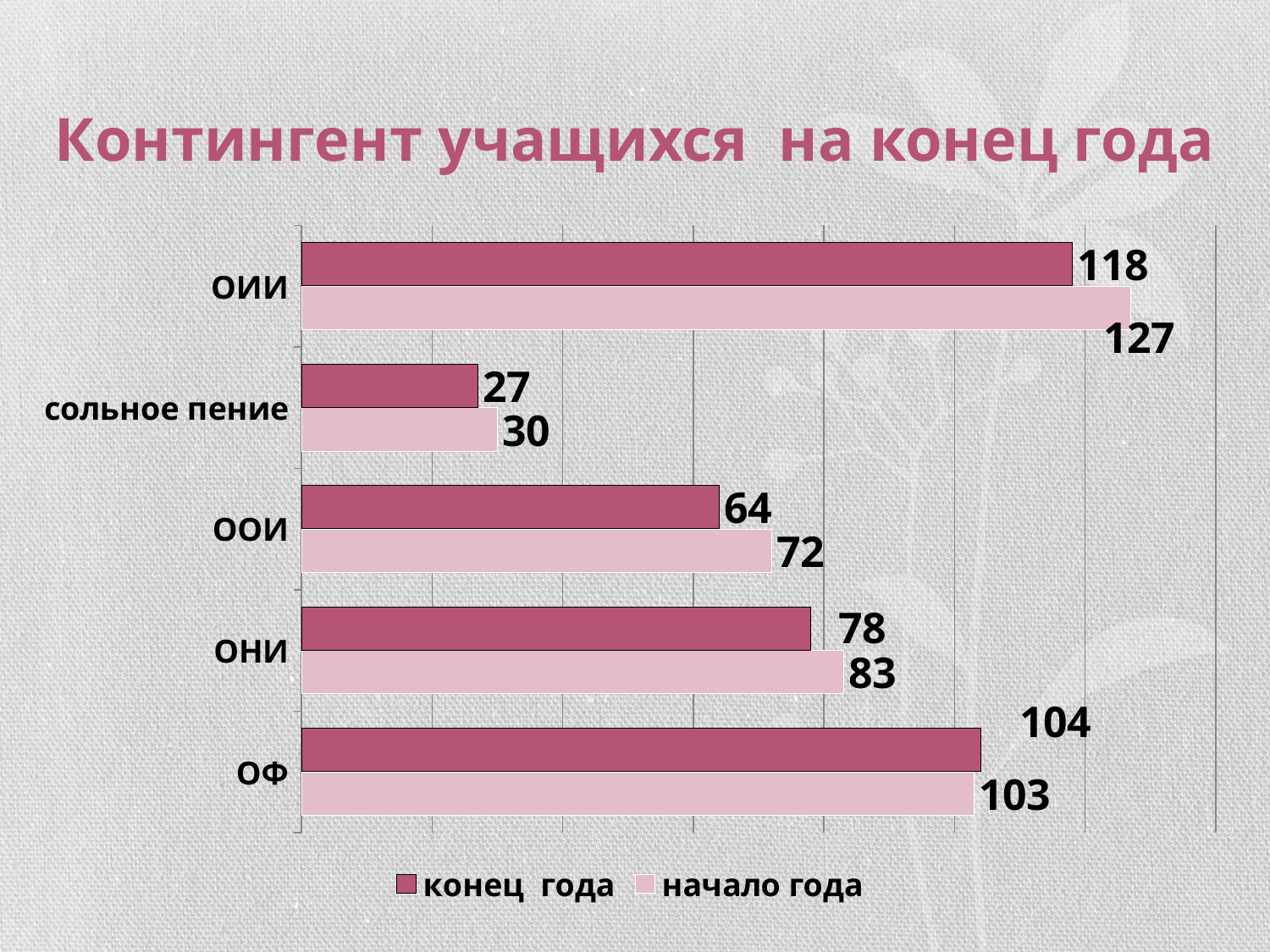
What kind of chart is shown on the slide? bar chart Which category has the highest value in the начало года series? ОИИ Which is larger for ОНИ: the конец года value or the начало года value? начало года What is the difference between the начало года and конец года values for ОИИ? 9 What is the difference between the начало года and конец года values for ООИ? 8 Which category has the lowest value in the конец года series? сольное пение What is the value for ОИИ in the конец года series? 118 What is the value for сольное пение in the начало года series? 30 What is the value for ОФ in the начало года series? 103 What is the value for ООИ in the конец года series? 64 How many categories are shown on the chart? 5 How many series does the legend list? 2